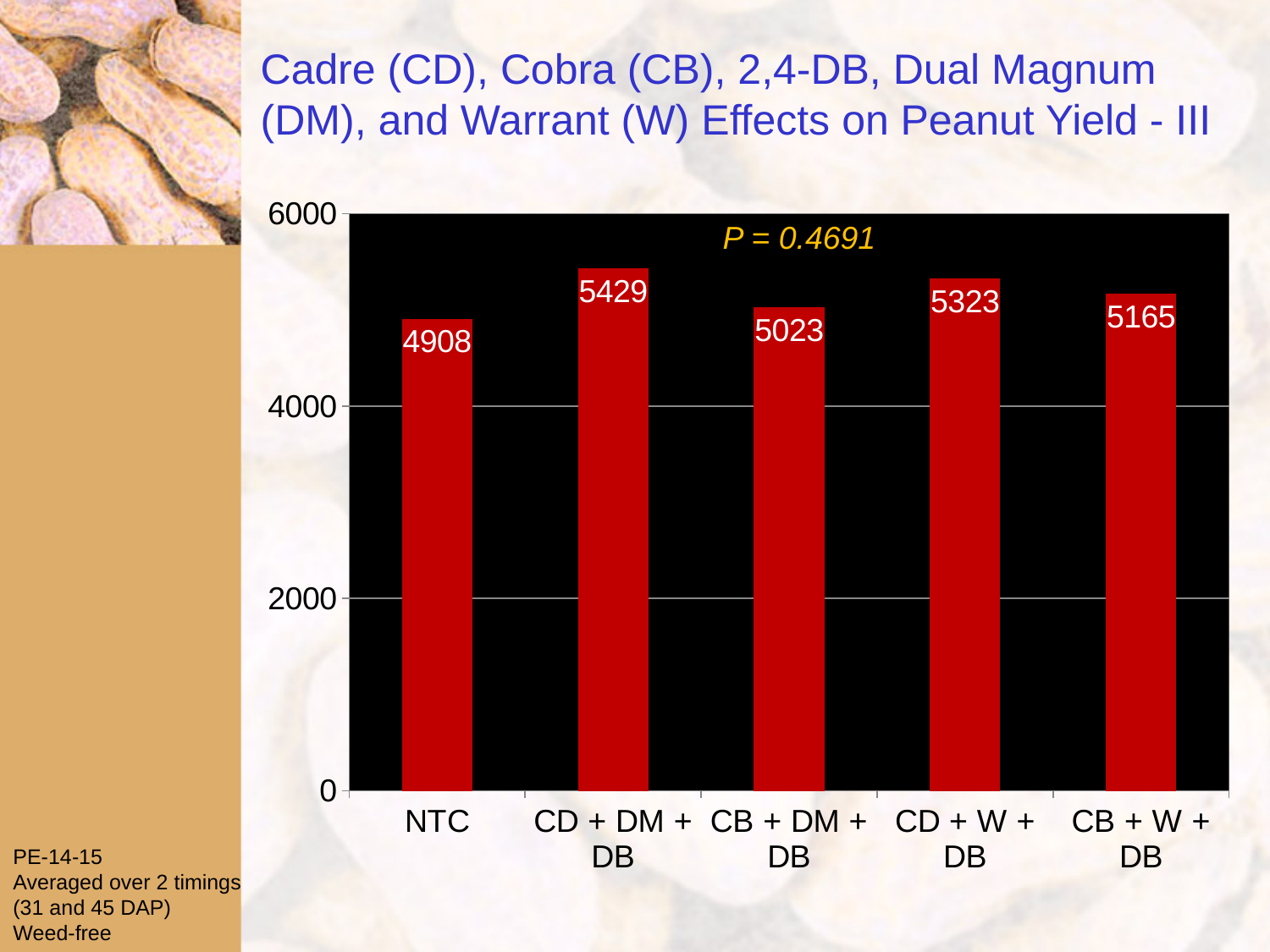
Which treatment has the lowest yield? NTC What kind of chart is shown on the slide? bar chart Which is larger, the value for CD + W + DB or the value for CB + W + DB? CD + W + DB What is the difference between the values for CD + W + DB and CB + DM + DB? 300 Which treatment has the highest yield? CD + DM + DB What is the value shown for CB + W + DB? 5165 What is the peanut yield value for NTC? 4908 What is the difference between the values for CD + DM + DB and NTC? 521 How many treatment categories are shown on the x axis? 5 Is the value for CB + DM + DB greater or less than 4000? greater What is the value shown for CD + DM + DB? 5429 What P value is printed on the chart? P = 0.4691